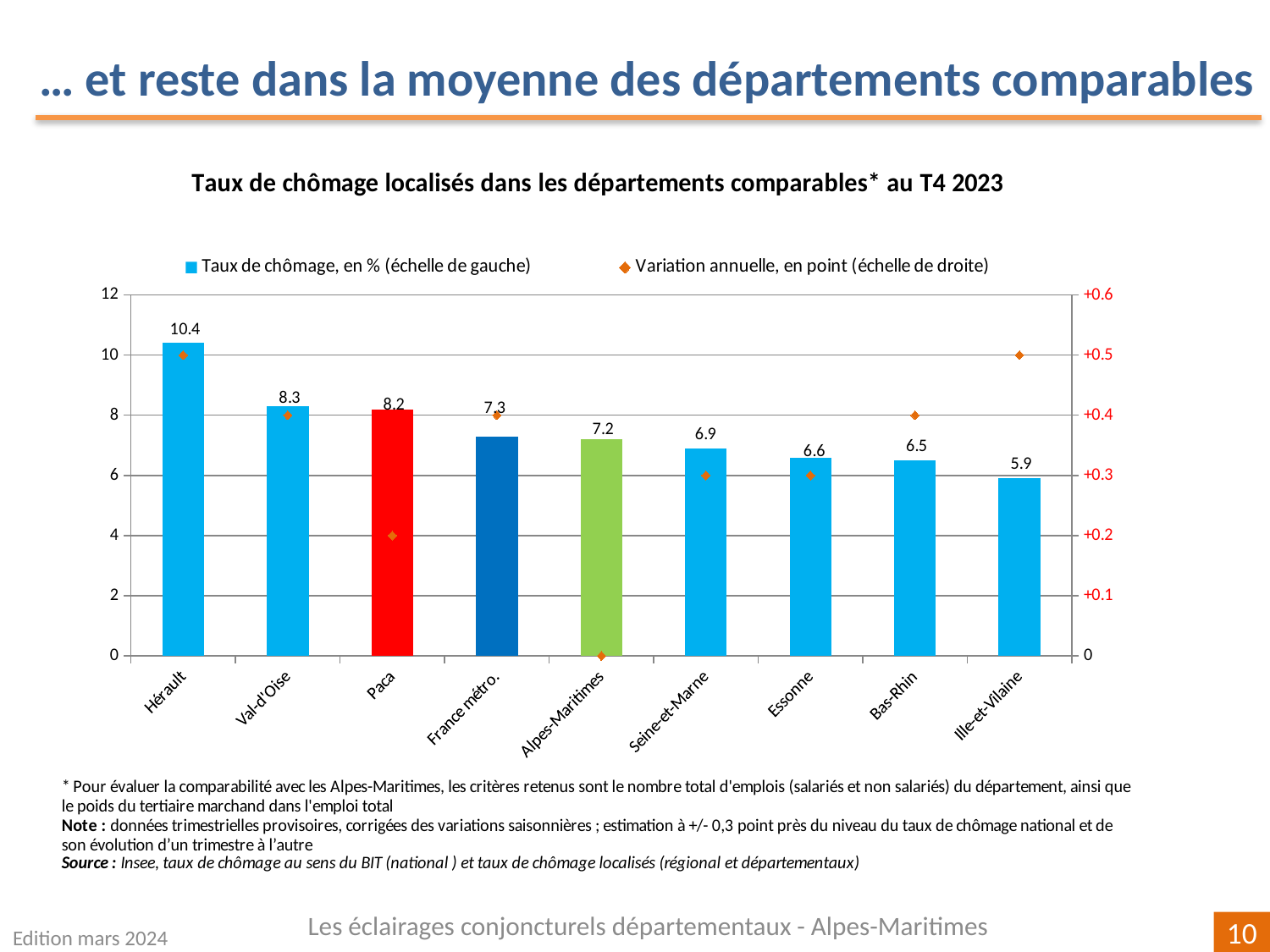
What colour is the bar for Paca? red Which category has the lowest unemployment rate in the chart? Ille-et-Vilaine How many categories are shown on the x axis of the chart? 9 What is the unemployment rate shown for Hérault? 10.4 What is the unemployment rate shown for Alpes-Maritimes? 7.2 Do the unemployment rate bars rise or fall from left to right along the x axis? fall Which department has the highest unemployment rate in the chart? Hérault How many series does the legend list? 2 What is the difference between the unemployment rate of Hérault and that of Ille-et-Vilaine? 4.5 Which has a higher unemployment rate, Val-d'Oise or Paca? Val-d'Oise What is the annual variation (in points) shown for Ille-et-Vilaine? +0.5 What is the annual variation (in points) shown for Alpes-Maritimes? 0